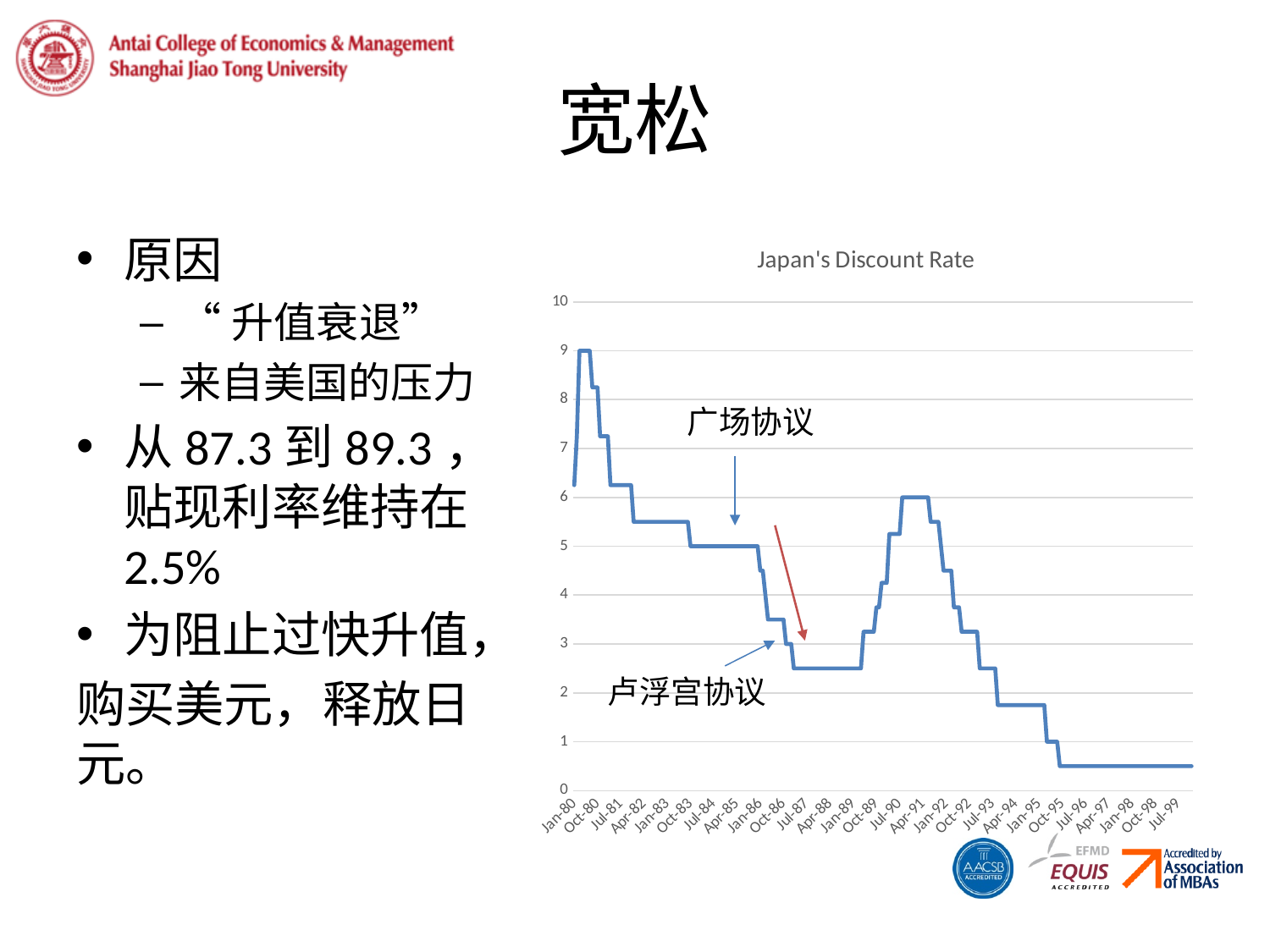
How many date labels are shown on the chart's horizontal axis? 27 What is the highest value shown on the chart's vertical axis? 10 Is the discount rate at Apr-91 greater or less than 5? greater What kind of chart is shown on the slide? line chart Which is higher, the discount rate at Apr-91 or at Jul-87? Apr-91 Overall, does Japan's discount rate rise or fall from Jan-80 to Jul-99? fall What is the peak value reached by Japan's discount rate on the chart? 9 Is the discount rate at Jul-99 greater or less than 1? less Is the discount rate at Jul-87 greater or less than 3? less Which is higher, the discount rate at Jan-80 or at Jul-99? Jan-80 What is the title of the chart? Japan's Discount Rate